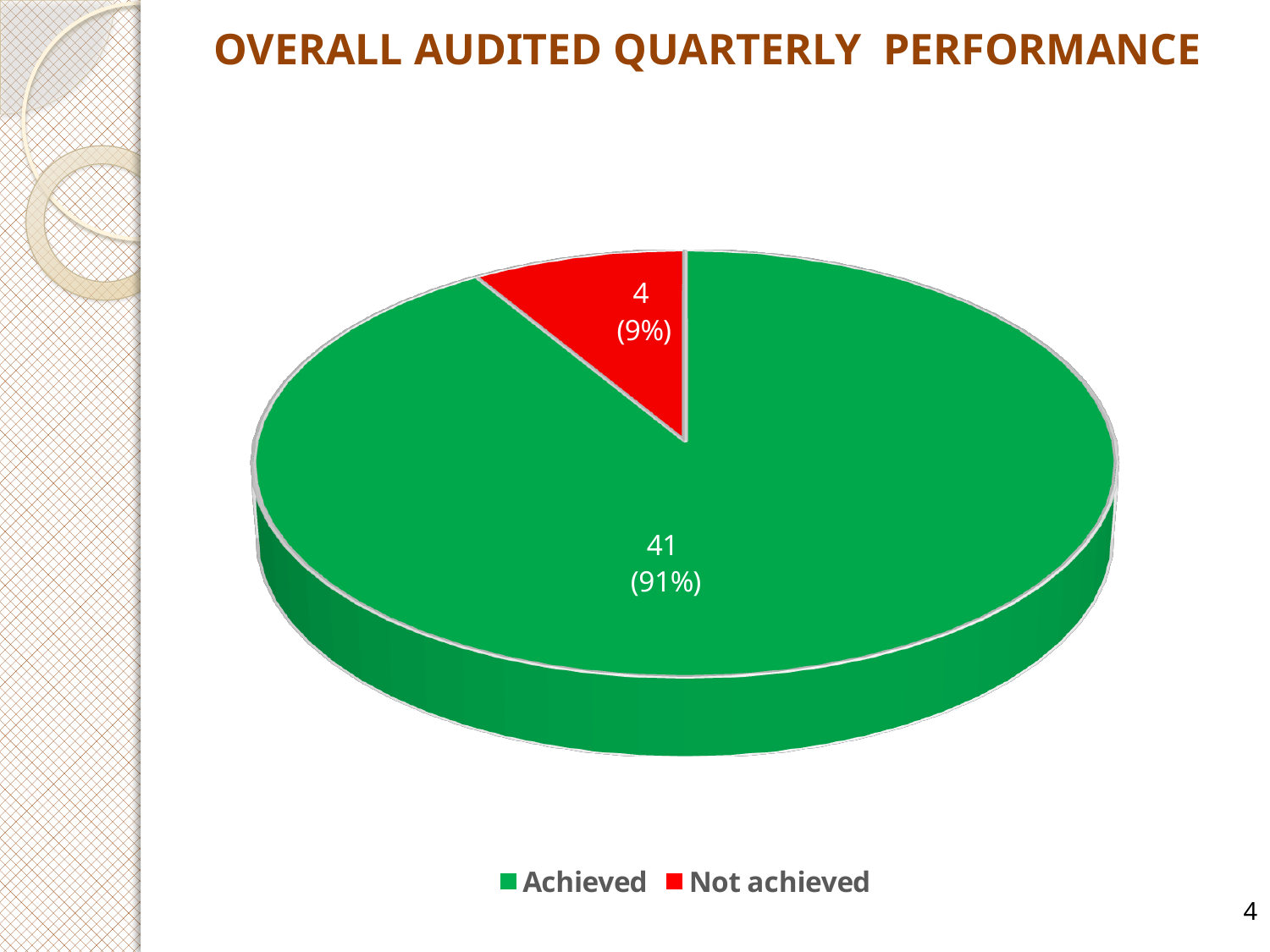
How many targets were Not achieved according to the pie chart? 4 What kind of chart is shown on the slide? Pie chart What percentage share of the pie does the Achieved slice represent? 91% Which category has the largest slice of the pie? Achieved How many targets were Achieved according to the pie chart? 41 What is the total of the Achieved and Not achieved counts? 45 What colour is the Not achieved slice in the pie chart? Red How many categories does the pie chart show? 2 Which category has the smallest slice of the pie? Not achieved What is the difference between the Achieved count and the Not achieved count? 37 Which is larger, the Achieved count or the Not achieved count? Achieved What percentage share of the pie does the Not achieved slice represent? 9%